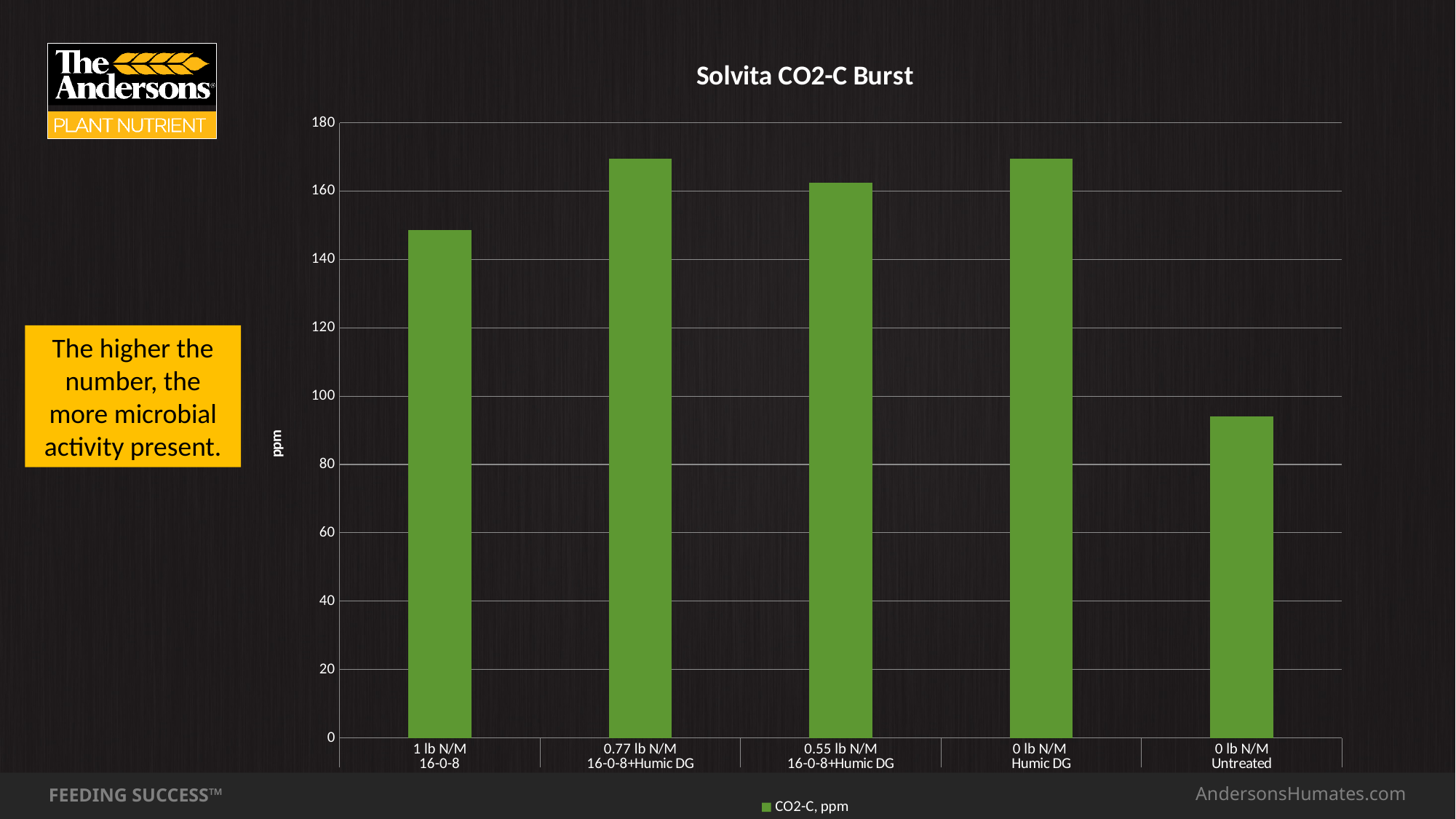
Which is larger, the value for 0 lb N/M Untreated or the value for 1 lb N/M 16-0-8? 1 lb N/M 16-0-8 Which category has the lowest CO2-C value? 0 lb N/M Untreated How many series does the legend list? 1 Is the value for 0.77 lb N/M 16-0-8+Humic DG greater or less than 160? greater What is the series name shown in the legend? CO2-C, ppm Is the value for 1 lb N/M 16-0-8 greater or less than 140? greater Which is larger, the value for 1 lb N/M 16-0-8 or the value for 0.55 lb N/M 16-0-8+Humic DG? 0.55 lb N/M 16-0-8+Humic DG Is the value for 0 lb N/M Untreated greater or less than 100? less What is the title of the chart? Solvita CO2-C Burst What kind of chart is shown on the slide? bar chart How many categories (bars) are plotted in the chart? 5